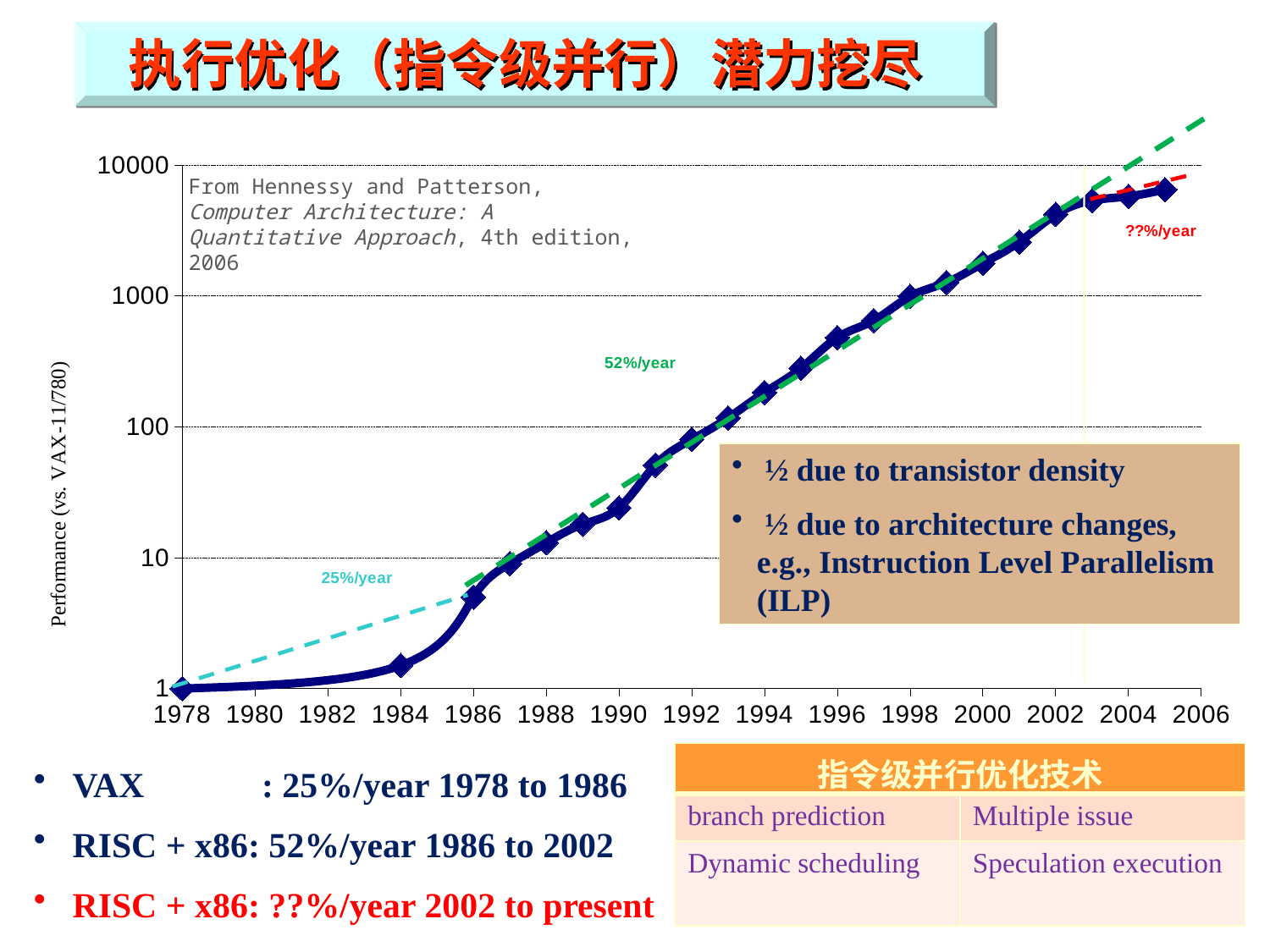
Which year has the lowest plotted performance value? 1978 Is the plotted performance value for 1984 greater or less than 10? less What kind of chart is shown on the slide? line chart Which year has the larger plotted performance value, 1984 or 2004? 2004 Is the plotted performance value for 1996 greater or less than 100? greater Is the plotted performance value for 2000 greater or less than 1000? greater What is the label on the vertical axis of the chart? Performance (vs. VAX-11/780) What annual growth rate is annotated on the chart for the 1986 to 2002 segment? 52%/year Do the plotted performance values rise or fall from 1978 to 2006? rise